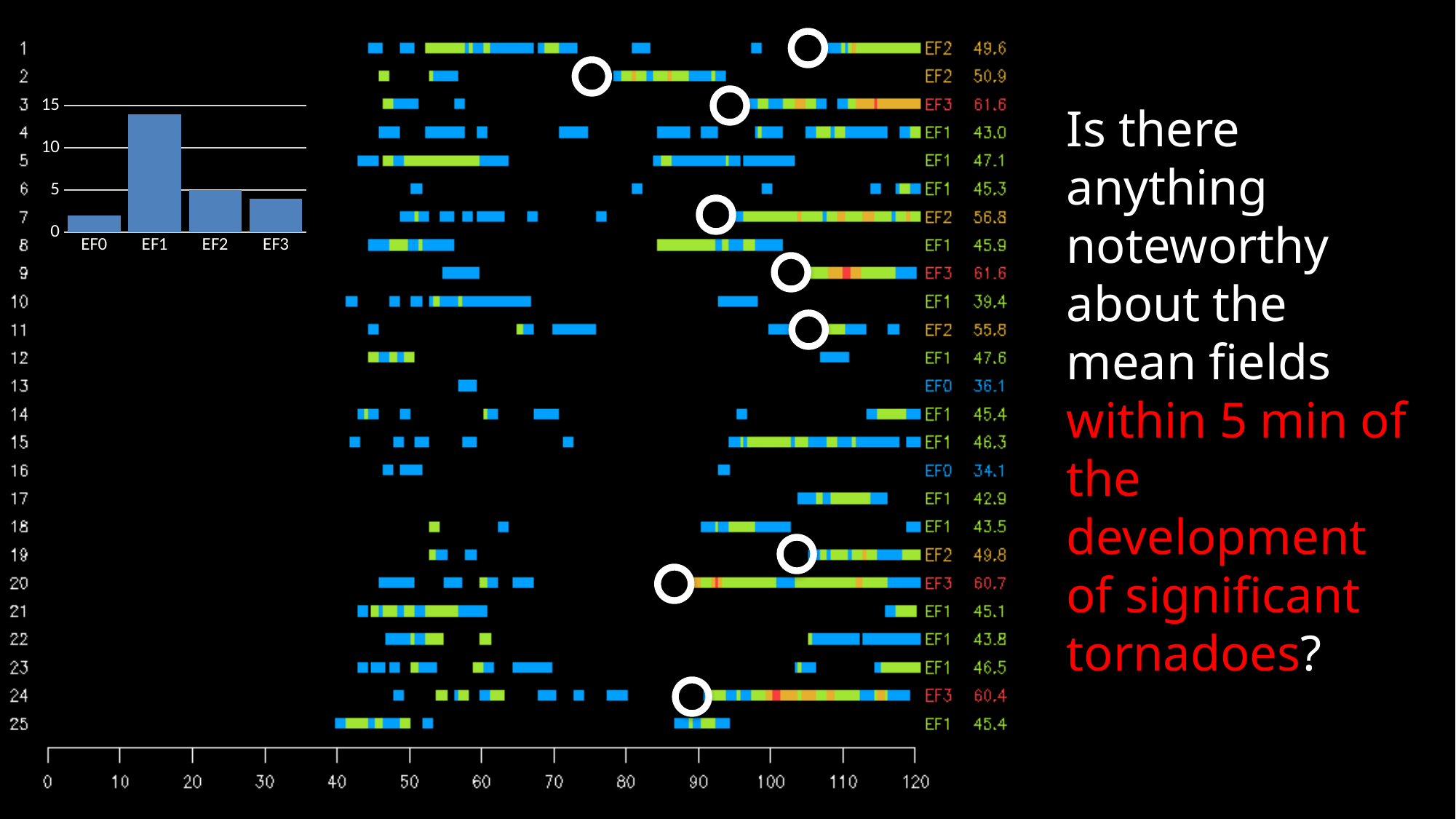
In the large timeline chart, how many numbered rows are plotted? 25 What kind of chart is the small chart in the top left of the slide? bar chart In the small bar chart at the top left, is the value for EF1 greater or less than 10? greater In the large timeline chart, what is the highest value shown on the x axis? 120 In the large timeline chart, what value is printed at the right end of row 3? 61.6 In the small bar chart at the top left, which is larger, the bar for EF1 or the bar for EF2? EF1 In the large timeline chart, which row has the lowest printed value at the right? 16 In the small bar chart at the top left, which category has the tallest bar? EF1 In the small bar chart at the top left, which category has the shortest bar? EF0 In the large timeline chart, what EF rating is printed for row 13? EF0 How many categories are shown on the x axis of the small bar chart at the top left? 4 In the small bar chart at the top left, is the value for EF0 greater or less than 5? less